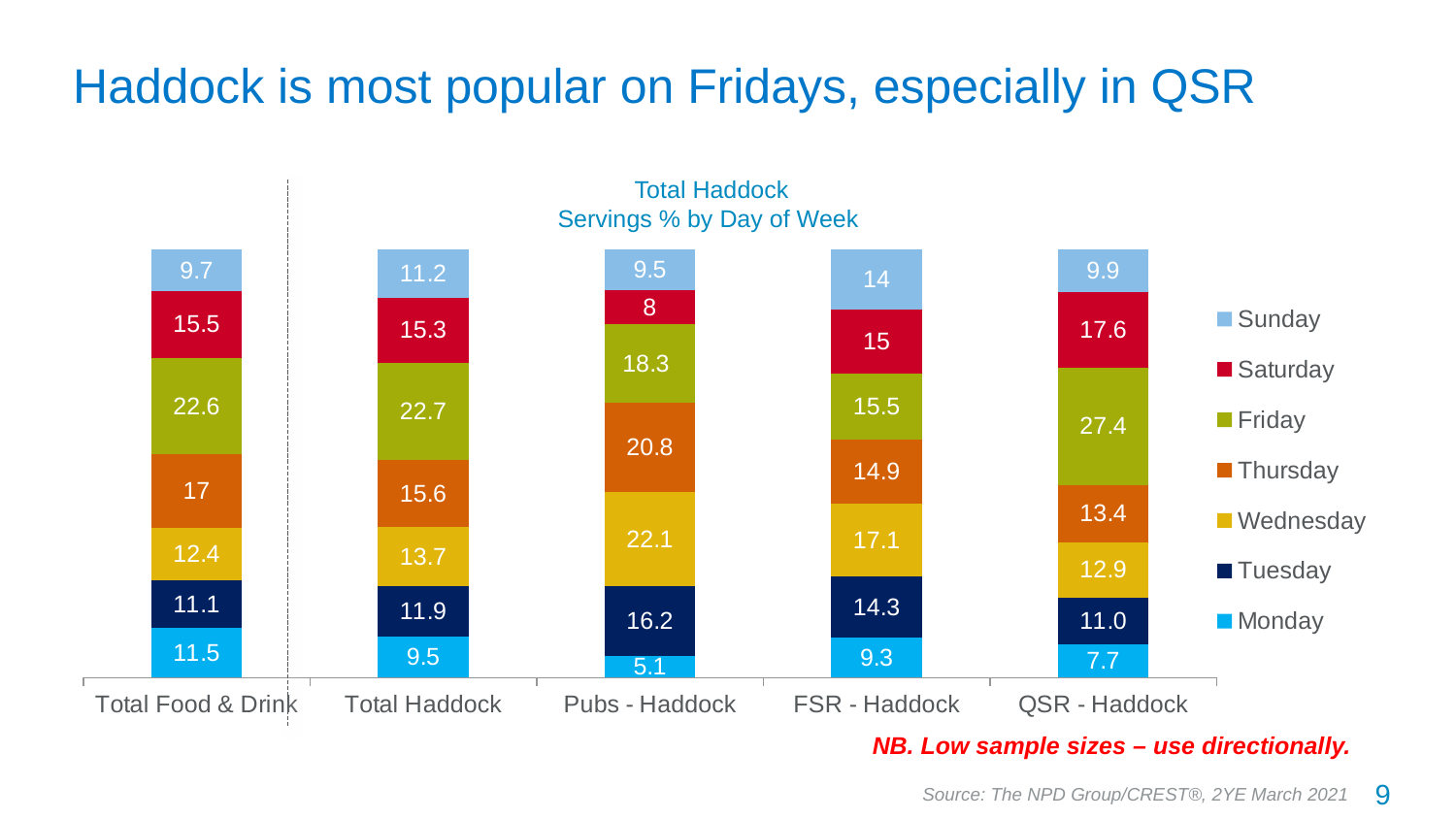
Which category has the highest Friday value? QSR - Haddock What is the difference between the Friday value for QSR - Haddock and the Friday value for Total Haddock? 4.7 What is the title of the chart? Total Haddock Servings % by Day of Week Which category has the lowest Monday value? Pubs - Haddock What is the Friday value for QSR - Haddock? 27.4 What kind of chart is shown on the slide? Stacked bar chart What is the Sunday value for FSR - Haddock? 14 What is the difference between the Saturday value for QSR - Haddock and the Saturday value for Pubs - Haddock? 9.6 Which has the larger Wednesday value, Pubs - Haddock or FSR - Haddock? Pubs - Haddock What is the Monday value for Pubs - Haddock? 5.1 How many series does the legend list? 7 How many categories are shown on the x axis? 5